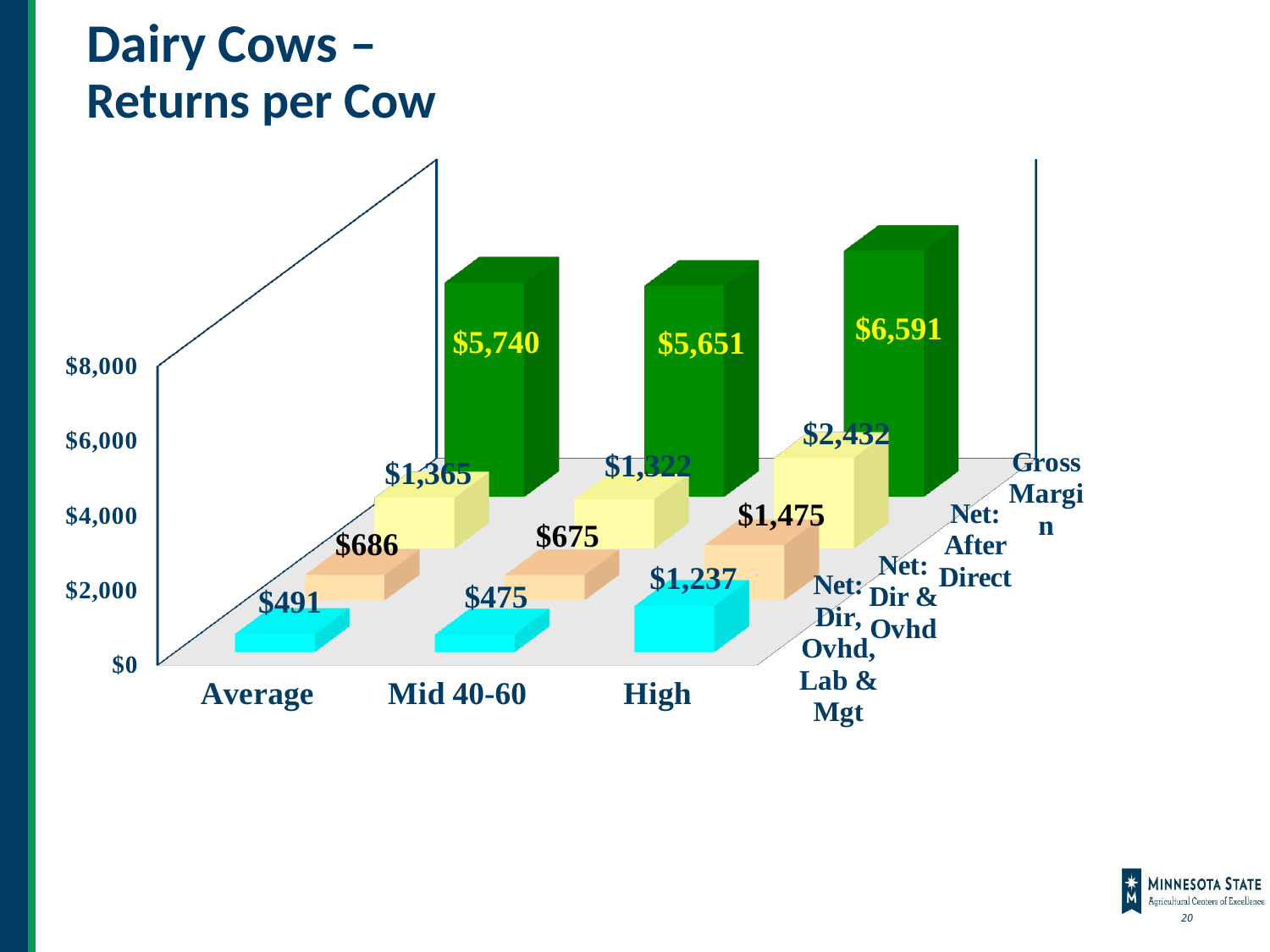
Which group has the highest Gross Margin? High What is the Net: Dir, Ovhd, Lab & Mgt value for the Average group? $491 Which group has the lowest Net: Dir, Ovhd, Lab & Mgt value? Mid 40-60 How many series are plotted in the chart? 4 What is the Net: After Direct value for the Mid 40-60 group? $1,322 What is the difference between the Gross Margin for High and the Gross Margin for Average? $851 How many groups are shown along the x axis? 3 What kind of chart is shown on the slide? bar chart What is the Gross Margin value for the High group? $6,591 Is the Gross Margin for Mid 40-60 greater or less than $6,000? less What is the Net: Dir & Ovhd value for the High group? $1,475 Which is larger: the Net: After Direct value for Average or for Mid 40-60? Average